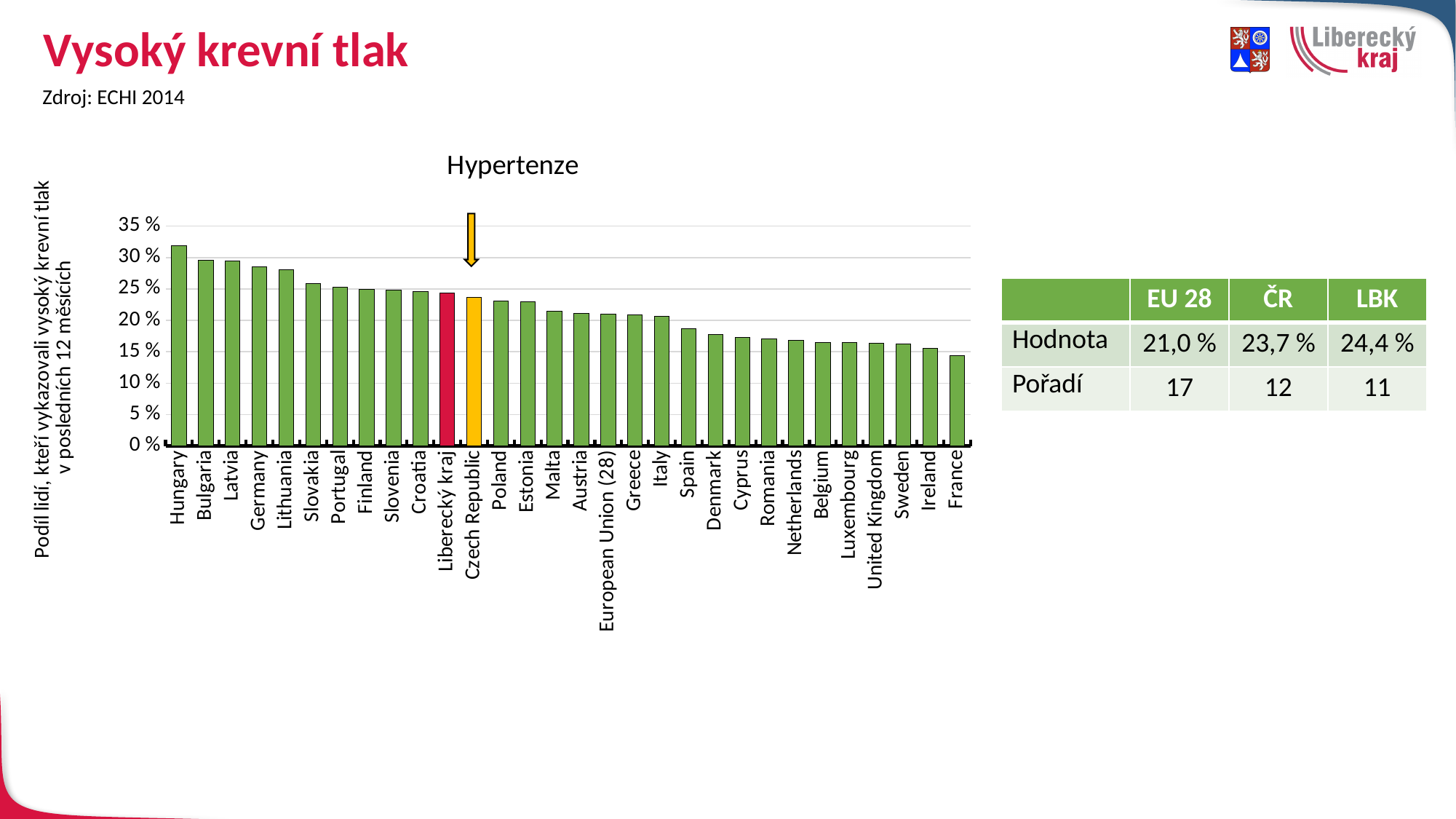
Which category has the lowest value in the chart? France What type of chart is shown on the slide? bar chart Do the values rise or fall from left to right along the x axis? fall What is the value for Czech Republic? 23,7 % What is the title of the chart? Hypertenze What is the value for Liberecký kraj? 24,4 % Is the value for Spain greater or less than 20 %? less Is the value for Hungary greater or less than 30 %? greater Which is larger, the value for Germany or the value for Italy? Germany How many bars (categories) are plotted in the chart? 30 Which category has the highest value in the chart? Hungary What is the value for European Union (28)? 21,0 %